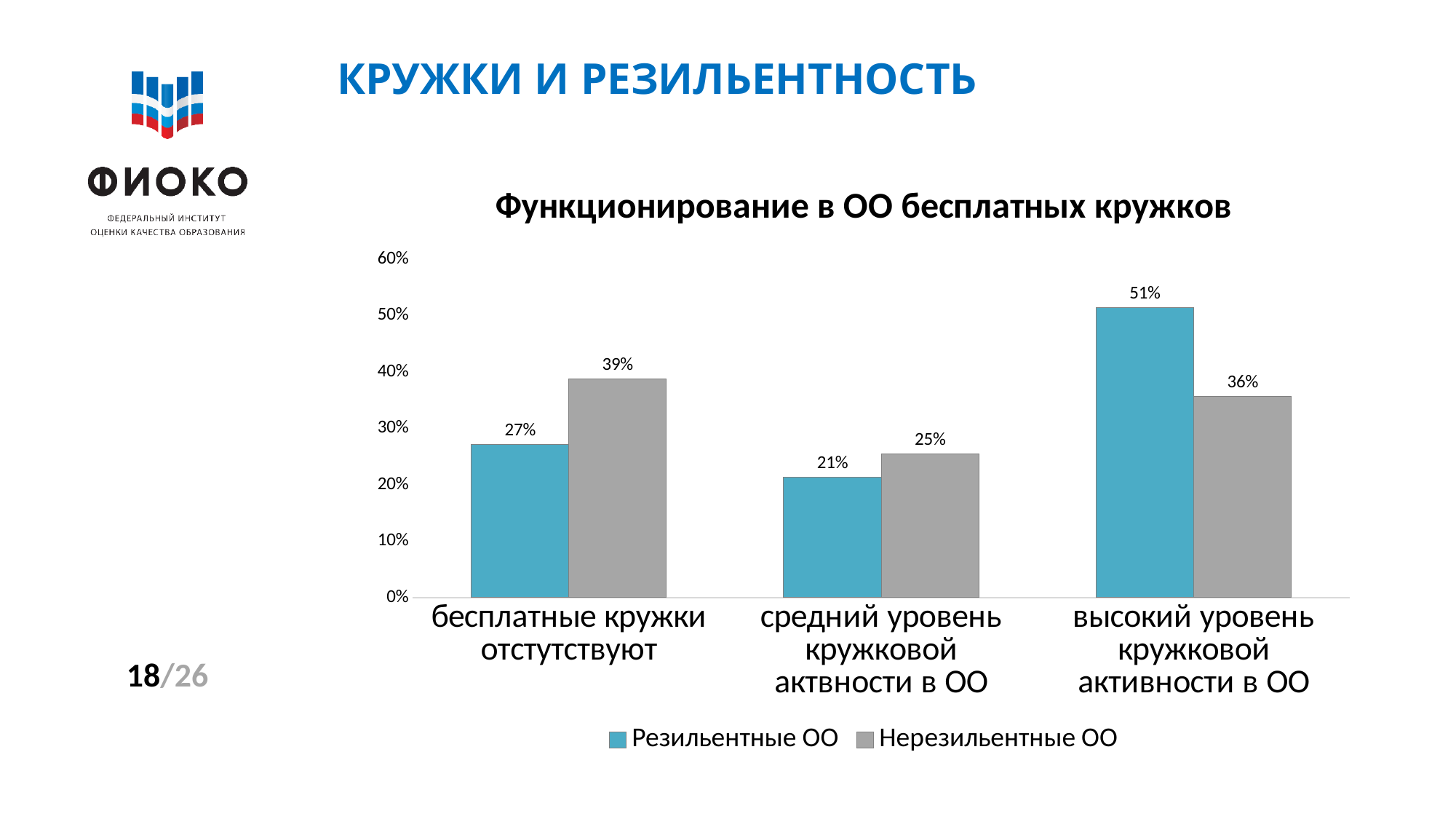
What is the title of the chart? Функционирование в ОО бесплатных кружков What is the value for Нерезильентные ОО in the category 'высокий уровень кружковой активности в ОО'? 36% Which category has the lowest value for Нерезильентные ОО? средний уровень кружковой актвности в ОО Which category has the highest value for Резильентные ОО? высокий уровень кружковой активности в ОО Is the value for Резильентные ОО in 'высокий уровень кружковой активности в ОО' greater or less than 50%? greater What is the value for Нерезильентные ОО in the category 'средний уровень кружковой актвности в ОО'? 25% How many categories are shown on the x axis? 3 How many series does the legend list? 2 What is the difference between Нерезильентные ОО and Резильентные ОО in the category 'бесплатные кружки отстутствуют'? 12% In the category 'высокий уровень кружковой активности в ОО', which series has the larger value: Резильентные ОО or Нерезильентные ОО? Резильентные ОО What kind of chart is shown on the slide? bar chart What is the value for Резильентные ОО in the category 'бесплатные кружки отстутствуют'? 27%